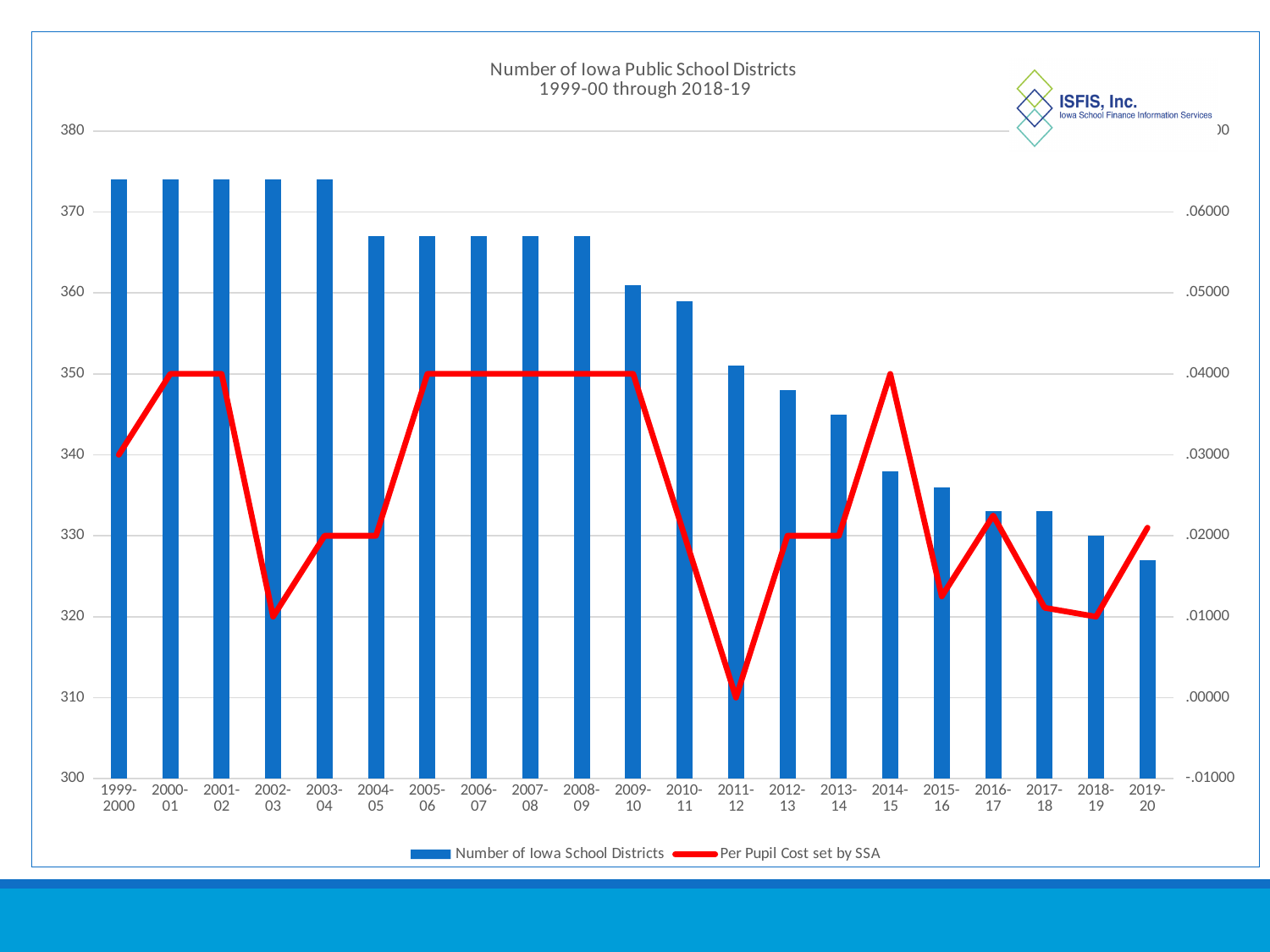
Which school year has the lowest number of Iowa school districts? 2019-20 Is the number of Iowa school districts for 2019-20 greater or less than 330? less How many series does the legend list? 2 Is the number of Iowa school districts for 1999-2000 greater or less than 370? greater What is the Per Pupil Cost set by SSA for 2014-15, as read on the right axis? .04000 What is the Per Pupil Cost set by SSA for 2011-12, as read on the right axis? .00000 What kind of chart is shown on the slide? A bar chart with a line overlay Which has more Iowa school districts, 2010-11 or 2011-12? 2010-11 Is the number of Iowa school districts for 2013-14 greater or less than 350? less What are the two series named in the legend? Number of Iowa School Districts; Per Pupil Cost set by SSA How many school years are shown along the x axis? 21 What is the Per Pupil Cost set by SSA for 2002-03, as read on the right axis? .01000